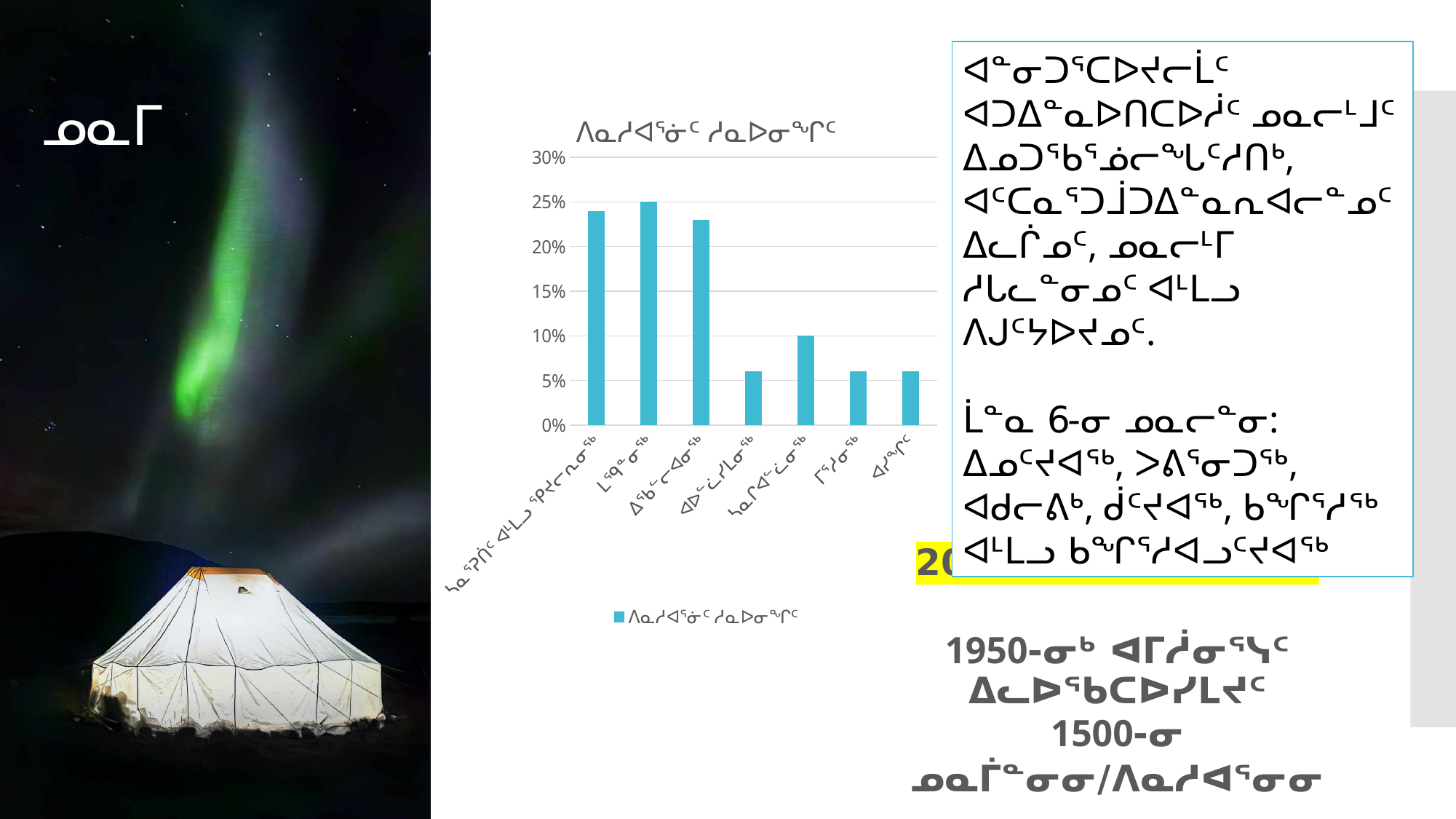
Is the value of the fourth bar from the left greater or less than 10%? less What colour are the bars in the chart? blue Is the value of the last bar on the right greater or less than 5%? greater What is the value of the second bar from the left? 25% Is the value of the first bar from the left greater or less than 20%? greater Which is larger, the first bar from the left or the fourth bar from the left? the first bar How many series does the chart legend list? 1 Which is larger, the fifth bar from the left or the sixth bar from the left? the fifth bar What is the value of the fifth bar from the left? 10% How many categories (bars) does the chart show? 7 What kind of chart is shown on the slide? bar chart